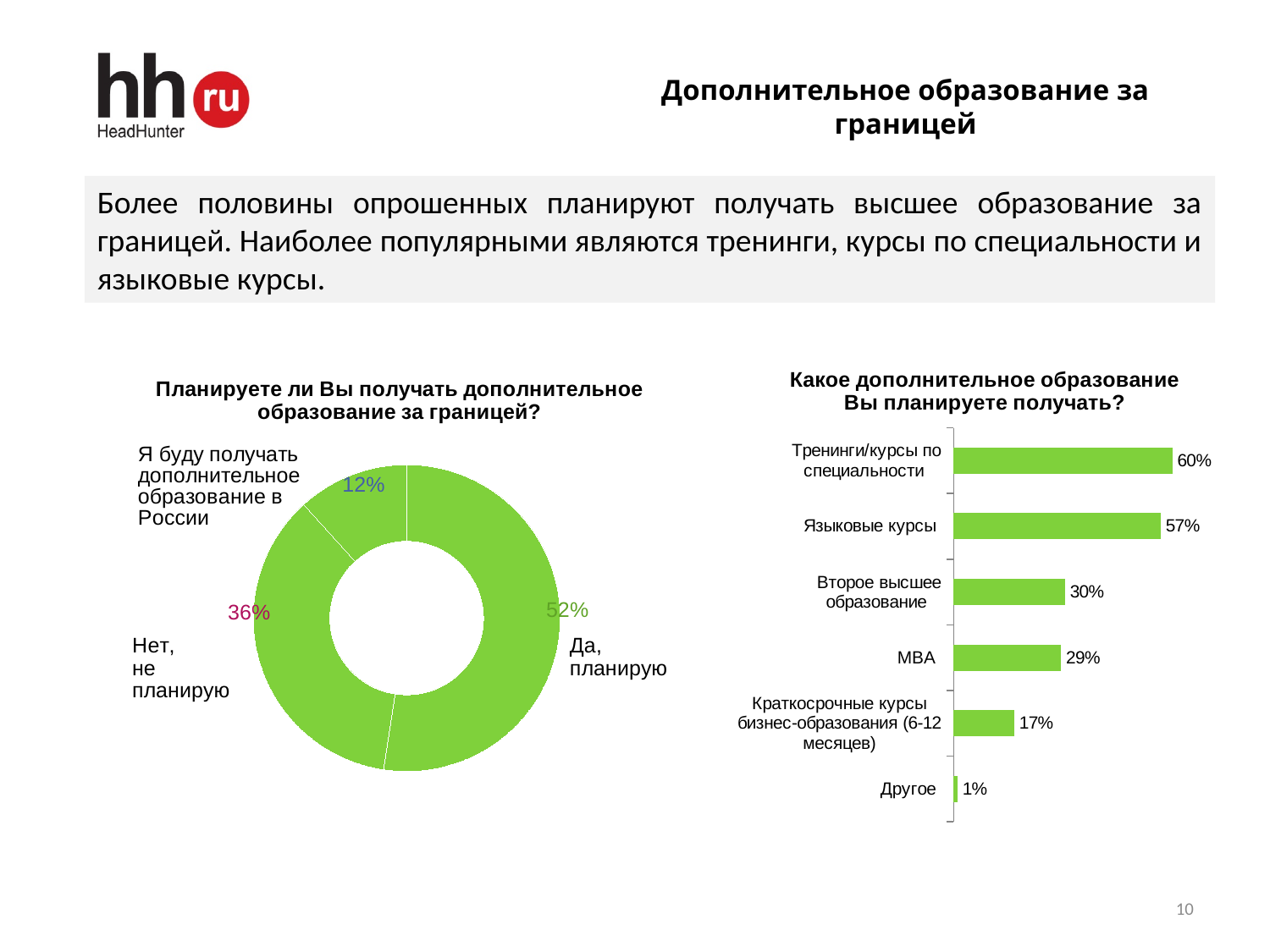
In the chart titled "Какое дополнительное образование Вы планируете получать?", which category has the lowest value? Другое In the chart titled "Планируете ли Вы получать дополнительное образование за границей?", how many slices are there? 3 In the chart titled "Планируете ли Вы получать дополнительное образование за границей?", what share of respondents said they will get additional education in Russia? 12% In the chart titled "Планируете ли Вы получать дополнительное образование за границей?", what share of respondents answered "Да, планирую"? 52% In the chart titled "Планируете ли Вы получать дополнительное образование за границей?", what share of respondents answered "Нет, не планирую"? 36% In the chart titled "Какое дополнительное образование Вы планируете получать?", what is the value for "MBA"? 29% In the chart titled "Какое дополнительное образование Вы планируете получать?", which category has the highest value? Тренинги/курсы по специальности In the chart titled "Какое дополнительное образование Вы планируете получать?", how many categories are shown? 6 In the chart titled "Какое дополнительное образование Вы планируете получать?", what is the value for "Языковые курсы"? 57% What kind of chart is the one titled "Какое дополнительное образование Вы планируете получать?"? Bar chart What kind of chart is the one titled "Планируете ли Вы получать дополнительное образование за границей?"? Doughnut (pie) chart In the chart titled "Какое дополнительное образование Вы планируете получать?", what is the difference between "Тренинги/курсы по специальности" and "Второе высшее образование"? 30%